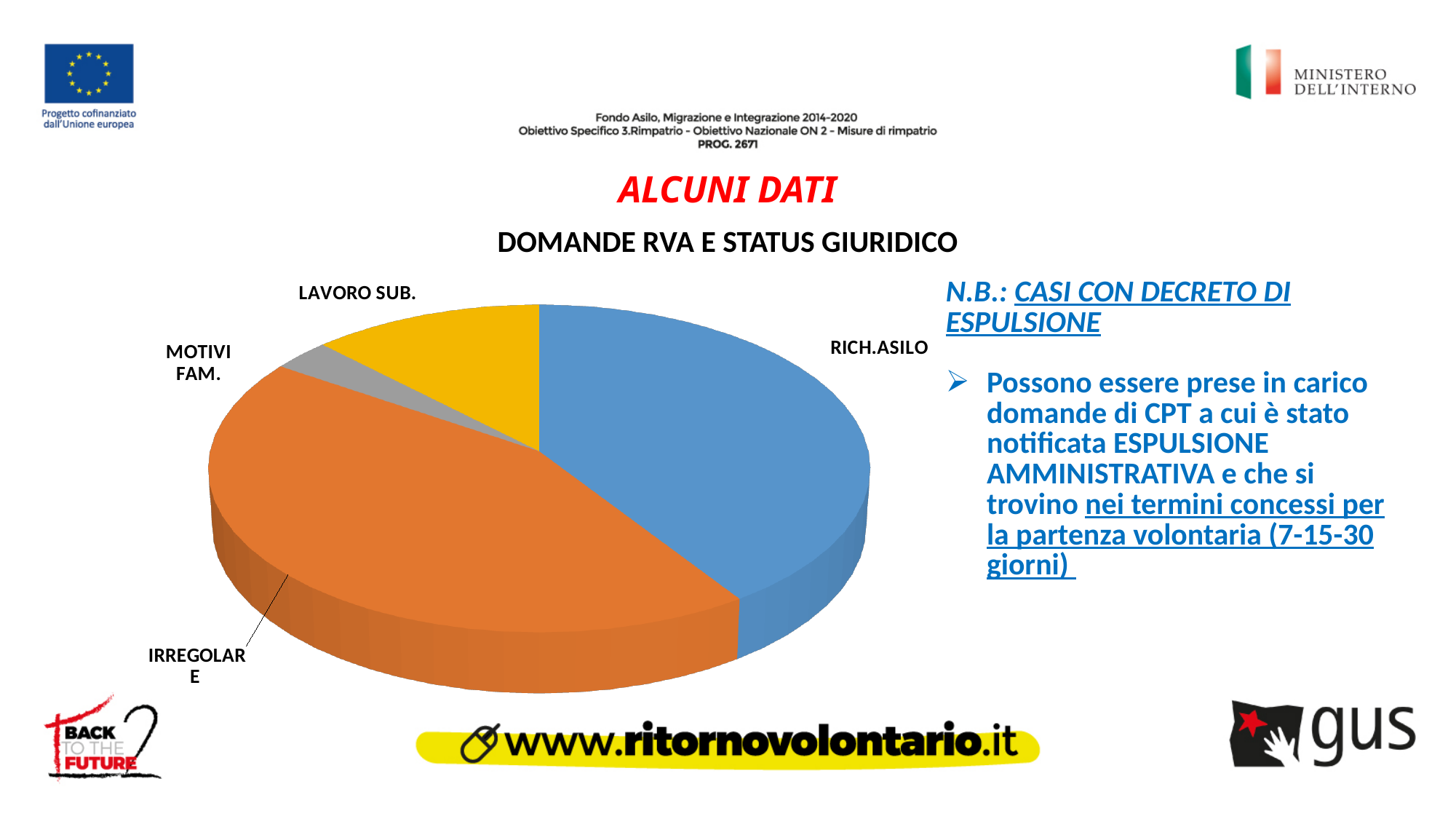
What is the title of the chart? DOMANDE RVA E STATUS GIURIDICO What colour is the IRREGOLARE slice of the pie? orange Which slice is larger, IRREGOLARE or MOTIVI FAM.? IRREGOLARE Which slice is larger, LAVORO SUB. or MOTIVI FAM.? LAVORO SUB. Which slice is larger, IRREGOLARE or RICH.ASILO? IRREGOLARE Which category has the largest slice of the pie? IRREGOLARE How many slices does the pie chart have? 4 What kind of chart is shown on the slide? pie chart Which category has the smallest slice of the pie? MOTIVI FAM.